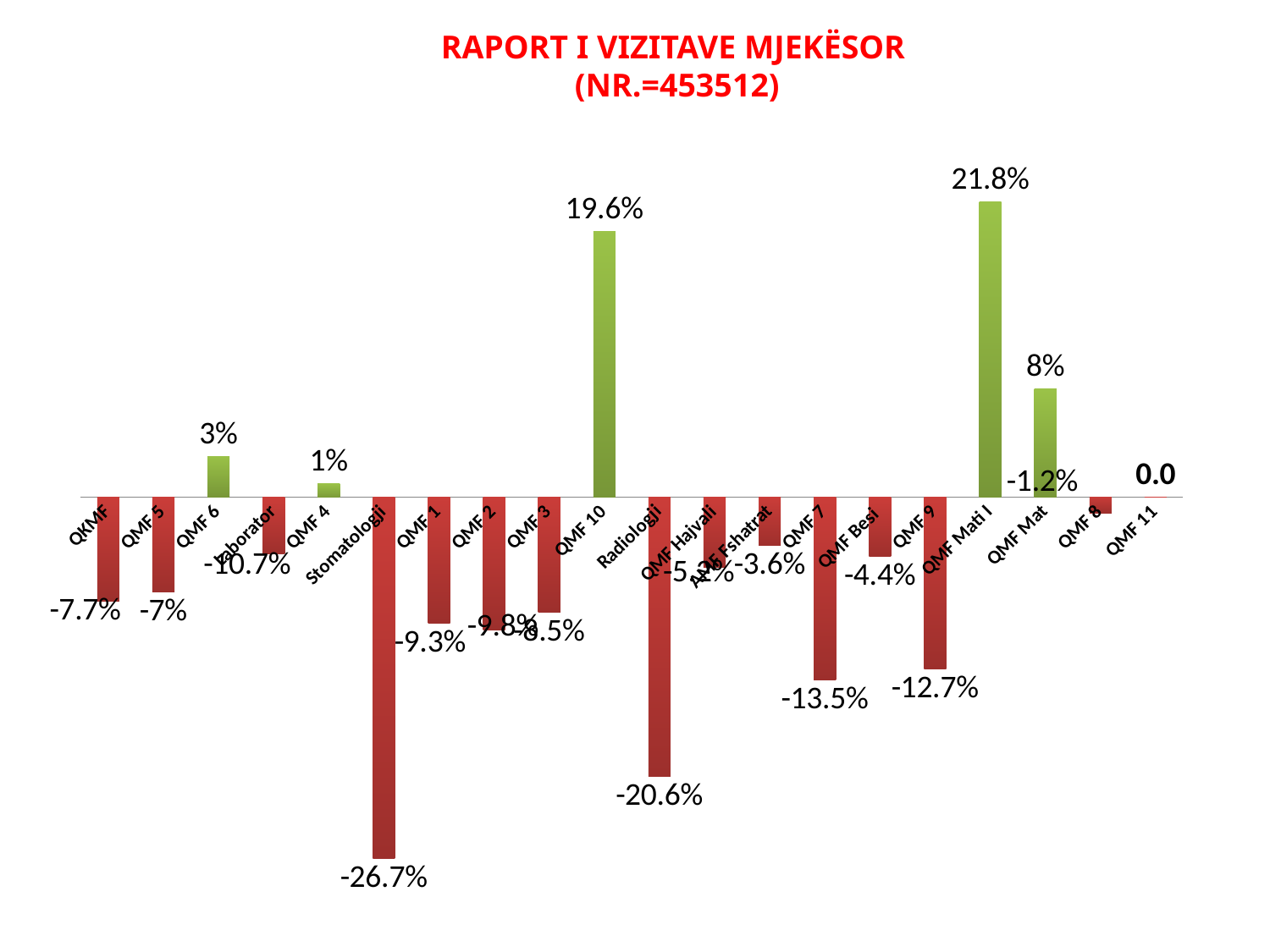
What is the difference between the values for QMF Mati I and QMF 10? 2.2% What kind of chart is shown on the slide? bar chart How many categories are plotted on the chart? 20 What is the value for QMF 9? -12.7% Which has the larger value, QMF 6 or QMF 4? QMF 6 What is the value for Radiologji? -20.6% What is the value for QMF Mat? 8% Which category has the highest value? QMF Mati I Which category has the lowest value? Stomatologji What is the value for Laborator? -10.7% What is the value for QMF 10? 19.6% What is the value for QMF 7? -13.5%